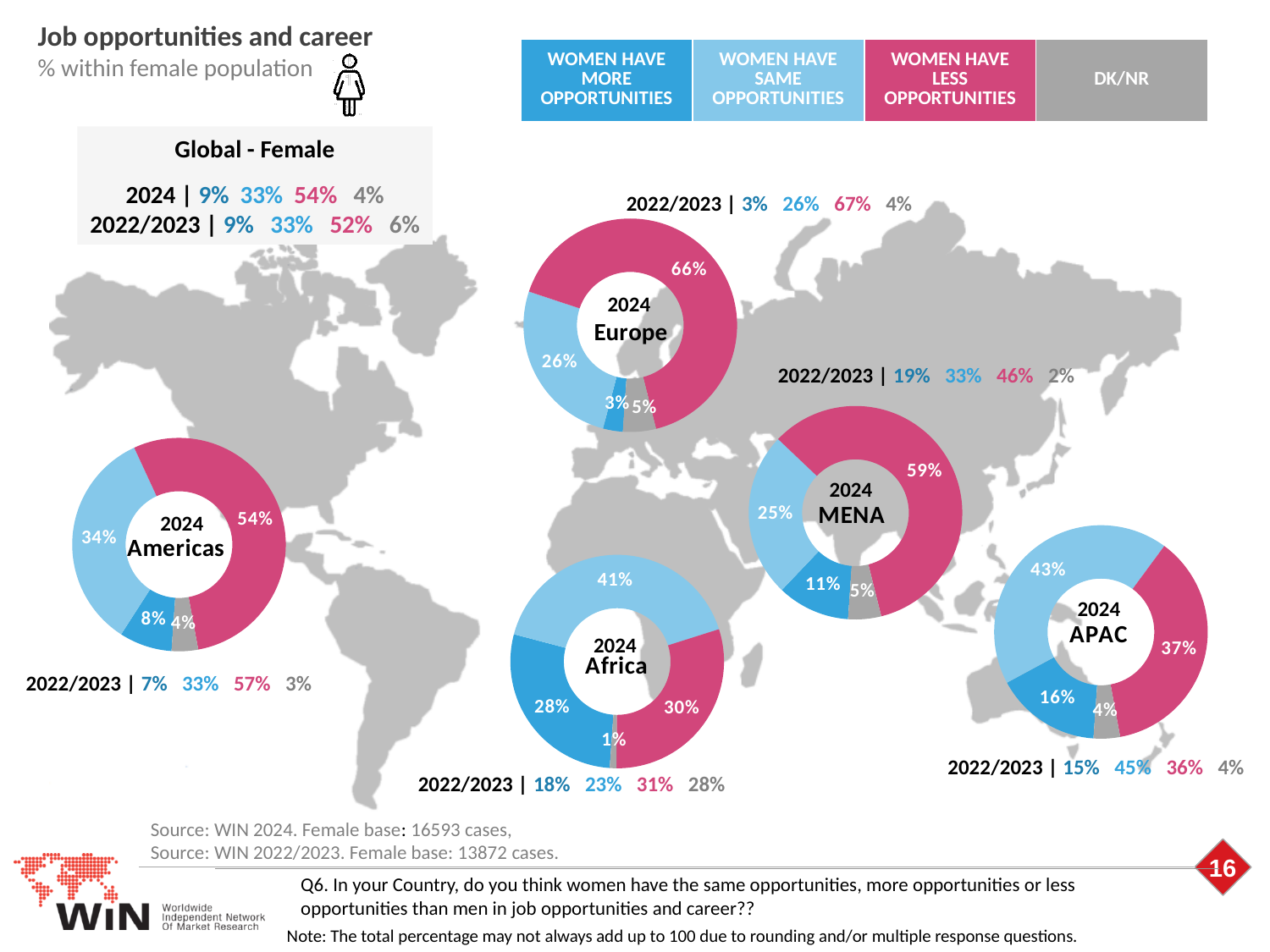
In the 2024 Africa donut chart, which category has the smallest share? DK/NR In the 2024 Americas donut chart, which category has the largest share? Women have less opportunities In the 2024 MENA donut chart, what is the DK/NR share? 5% In the 2024 Europe donut chart, what share of women say women have less opportunities? 66% In the 2024 MENA donut chart, what is the difference between the 'less opportunities' share and the 'same opportunities' share? 34% In the 2024 APAC donut chart, what share of women say women have the same opportunities? 43% In the 2024 Africa donut chart, what share of women say women have more opportunities? 28% What kind of chart is used to show the 2024 regional results on this slide? Donut (pie) chart In the 2024 Europe donut chart, is the 'same opportunities' share greater or less than the 'more opportunities' share? greater How many 2024 regional donut charts are shown on the slide? 5 In the 2024 APAC donut chart, which is larger: the 'same opportunities' share or the 'less opportunities' share? Same opportunities How many categories does the legend at the top of the slide list? 4